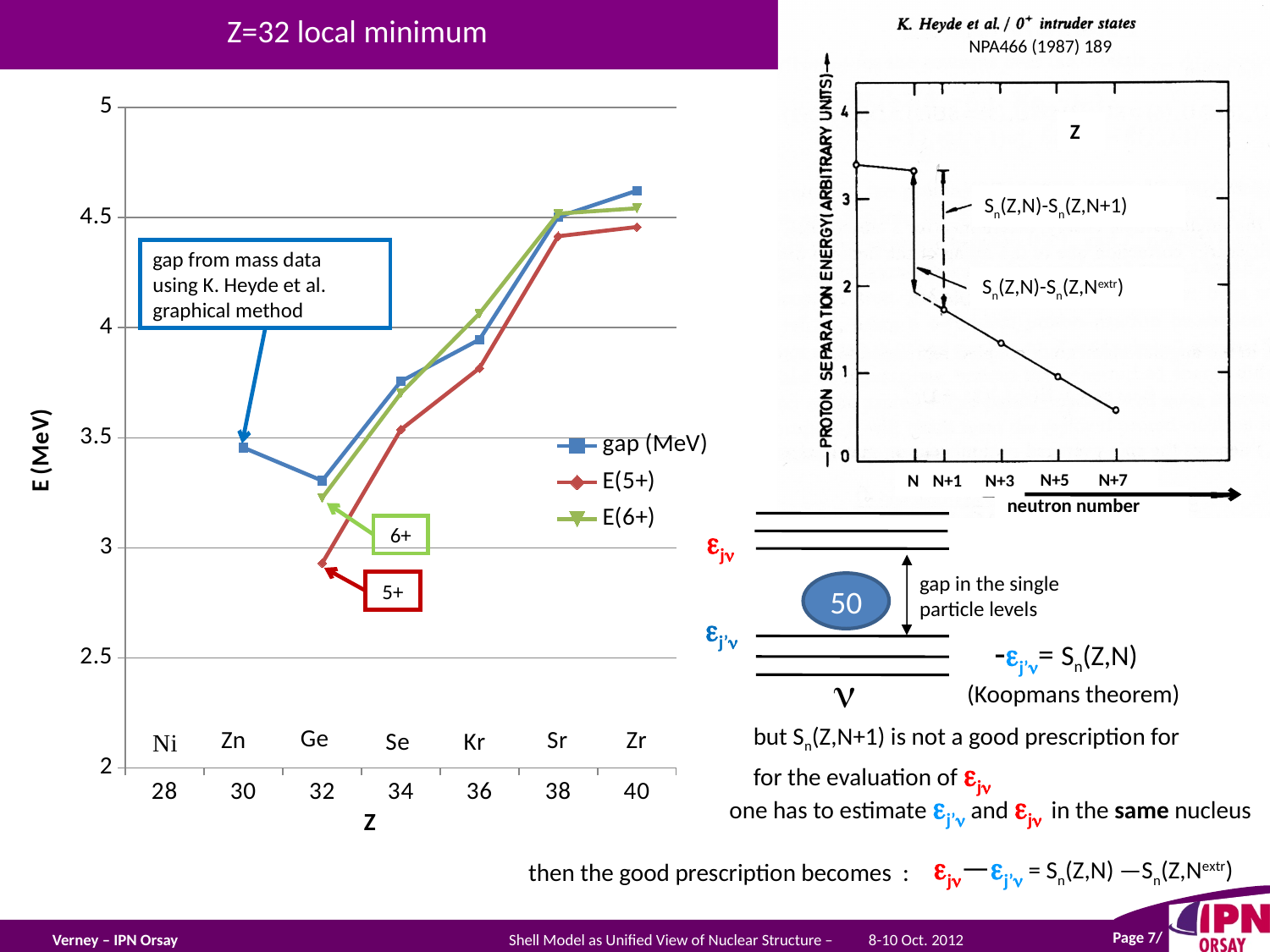
In the left chart, what are the three series named in the legend? gap (MeV), E(5+), E(6+) In the left chart, is the E(5+) value at Z=32 greater or less than 3? less In the left chart, at which Z value is the gap (MeV) series highest? 40 In the left chart, is the gap (MeV) value at Z=32 greater or less than 3.5? less In the left chart, do the E(5+) values rise or fall as Z increases from 32 to 40? rise In the left chart, is the E(6+) value at Z=32 greater or less than 3? greater What kind of chart is the chart on the left of the slide (E (MeV) versus Z)? line chart In the left chart, how many element labels (Ni, Zn, ...) are shown along the x axis? 7 In the left chart, what is the title of the vertical axis? E (MeV) In the left chart, at Z=32, which is larger: gap (MeV) or E(5+)? gap (MeV) In the left chart, at which Z value is the gap (MeV) series lowest? 32 In the left chart, how many series does the legend list? 3